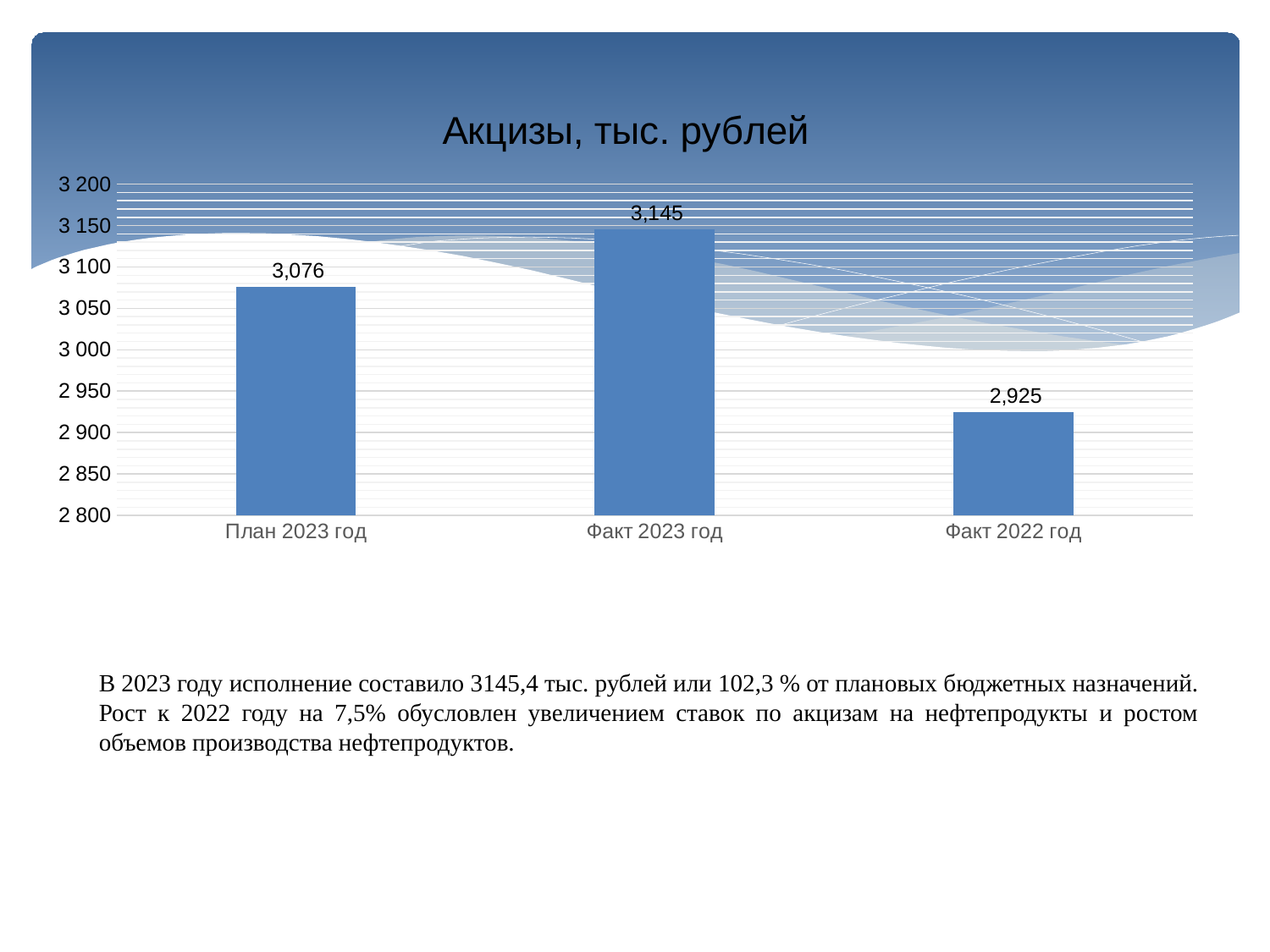
Which category has the lowest value? Факт 2022 год What is the value for Факт 2022 год? 2,925 Which category has the highest value? Факт 2023 год What is the title of the chart? Акцизы, тыс. рублей What is the difference between Факт 2023 год and Факт 2022 год? 220 Which is larger, План 2023 год or Факт 2022 год? План 2023 год What is the value for План 2023 год? 3,076 Is the value for Факт 2022 год greater or less than 3 000? less What kind of chart is shown on the slide? bar chart What is the value for Факт 2023 год? 3,145 What is the difference between Факт 2023 год and План 2023 год? 69 How many categories are shown on the chart? 3